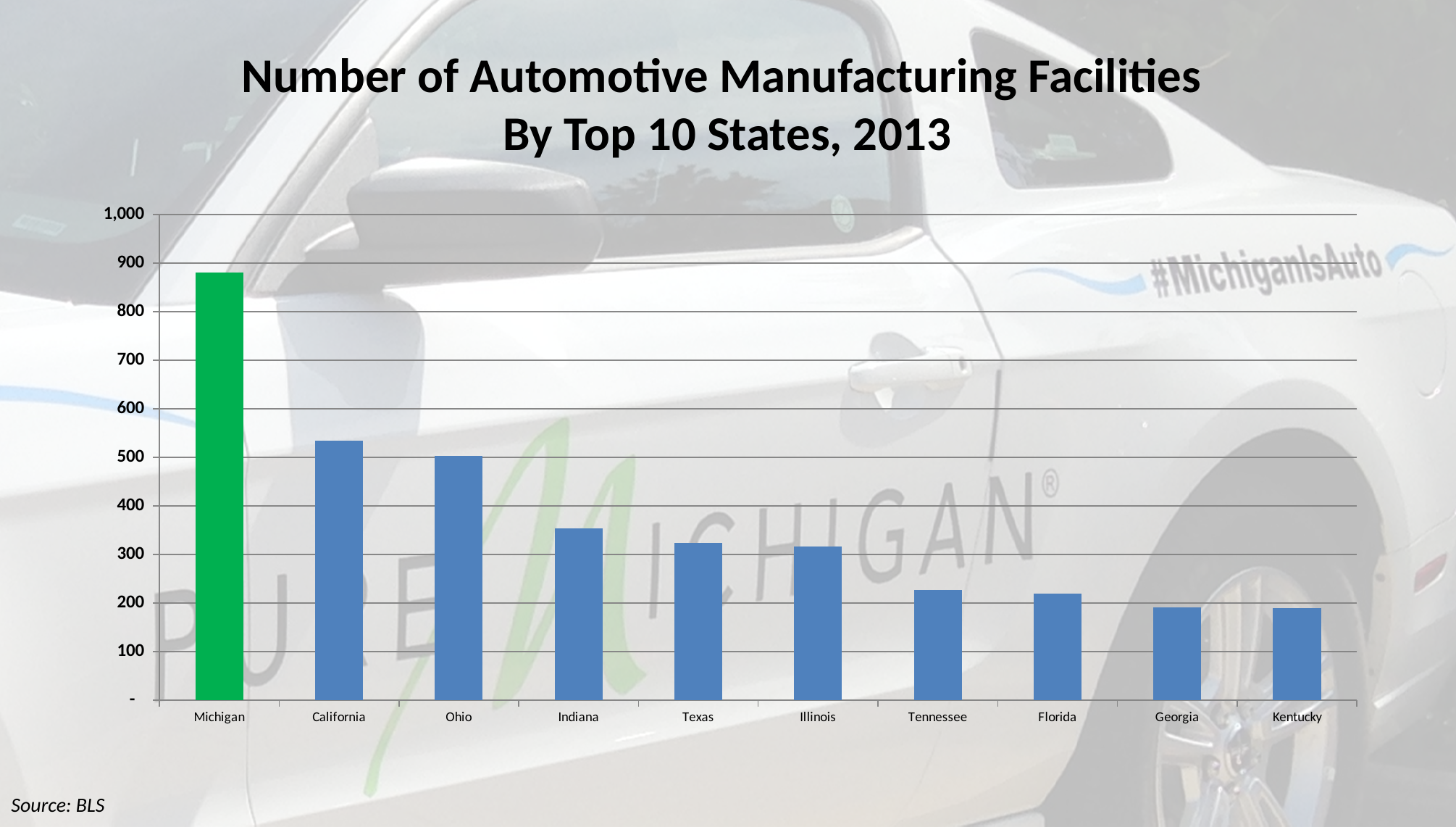
Which has more automotive manufacturing facilities, Michigan or California? Michigan How many states are shown on the chart? 10 Is the value for California greater or less than 500? greater Is the value for Indiana greater or less than 400? less What kind of chart is shown on the slide? bar chart Which has more automotive manufacturing facilities, Ohio or Indiana? Ohio Is the value for Michigan greater or less than 800? greater Do the values rise or fall moving from left to right across the states? fall What colour is the bar for Michigan? green Which state has the highest number of automotive manufacturing facilities? Michigan